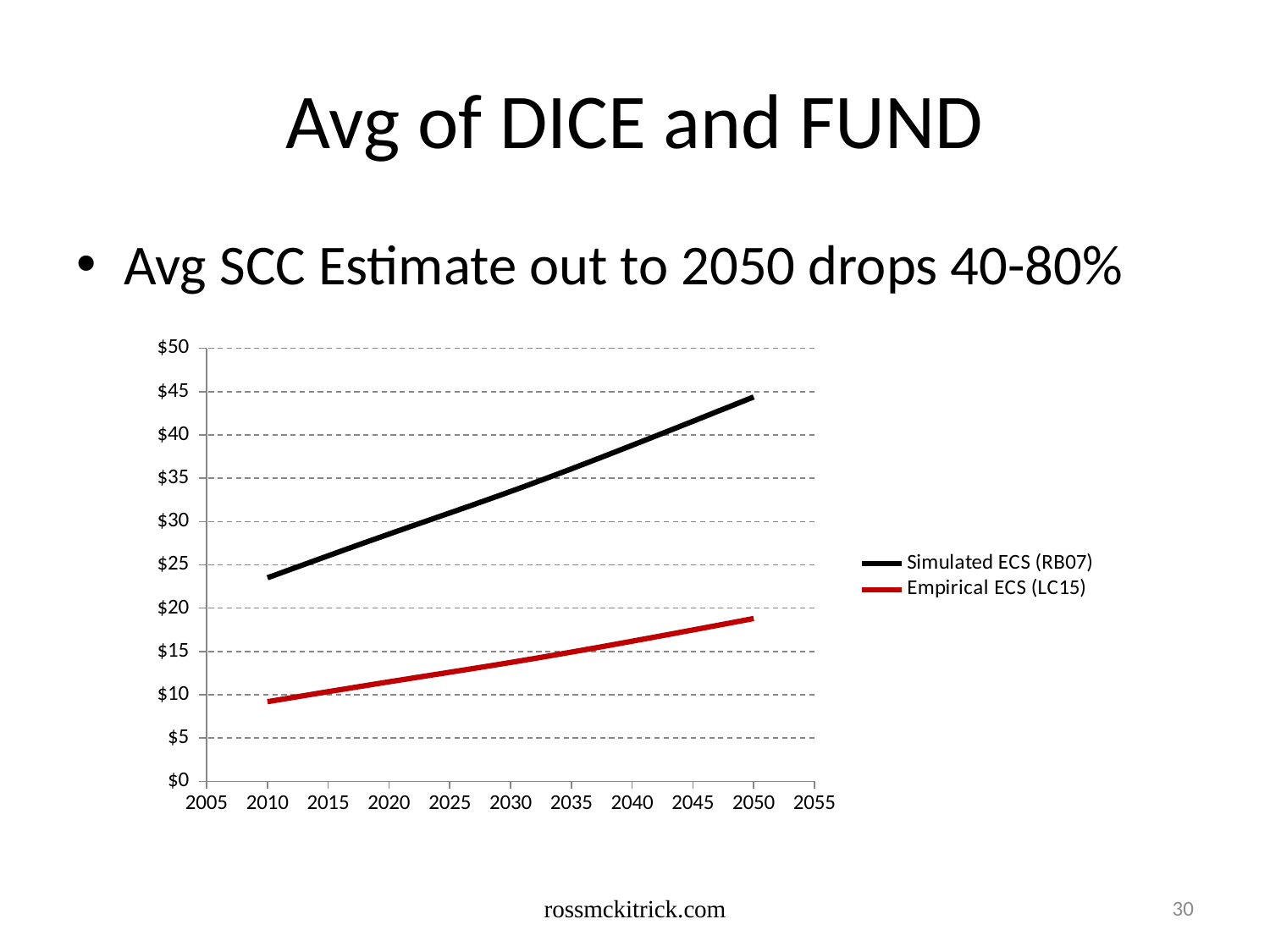
What kind of chart is shown on the slide? line chart Which series is plotted in black? Simulated ECS (RB07) Which series is plotted in red? Empirical ECS (LC15) Is the value for Empirical ECS (LC15) in 2010 greater or less than $15? less Is the value for Simulated ECS (RB07) in 2010 greater or less than $20? greater Is the value for Empirical ECS (LC15) in 2050 greater or less than $15? greater Which series has the higher value in 2030, Simulated ECS (RB07) or Empirical ECS (LC15)? Simulated ECS (RB07) Do the values for Simulated ECS (RB07) rise or fall from 2010 to 2050? rise Do the values for Empirical ECS (LC15) rise or fall from 2010 to 2050? rise How many series does the chart's legend list? 2